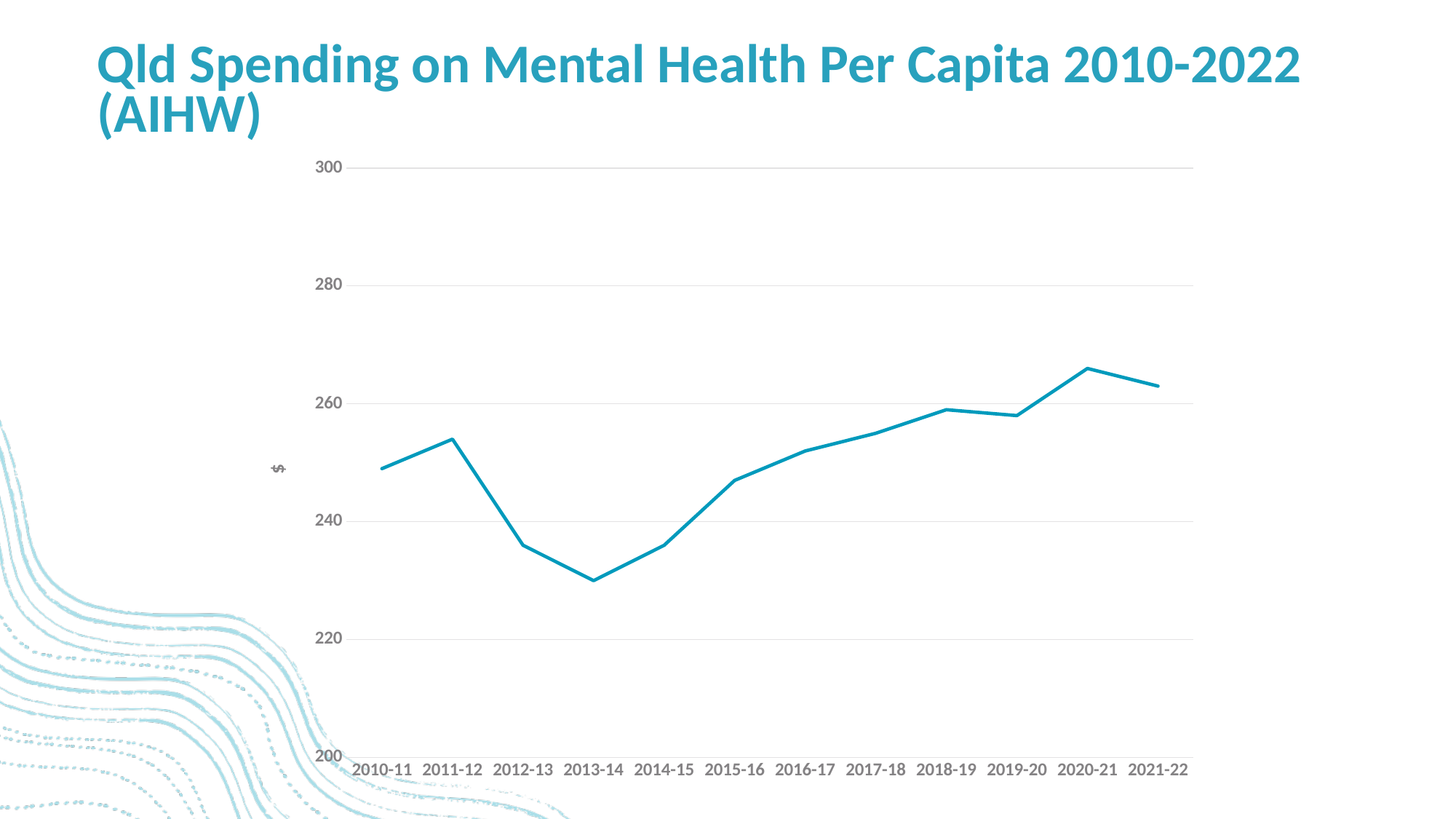
Is the value for 2020-21 greater or less than 260? greater Is the value for 2010-11 greater or less than 240? greater Which is larger, the value for 2011-12 or the value for 2012-13? 2011-12 Is the value for 2013-14 greater or less than 240? less Which is larger, the value for 2020-21 or the value for 2021-22? 2020-21 How many financial years are plotted along the x axis? 12 What kind of chart is shown on the slide? line chart What is the label on the vertical axis? $ Do the values rise or fall from 2013-14 to 2018-19? rise Which year has the highest spending on mental health per capita? 2020-21 Which year has the lowest spending on mental health per capita? 2013-14